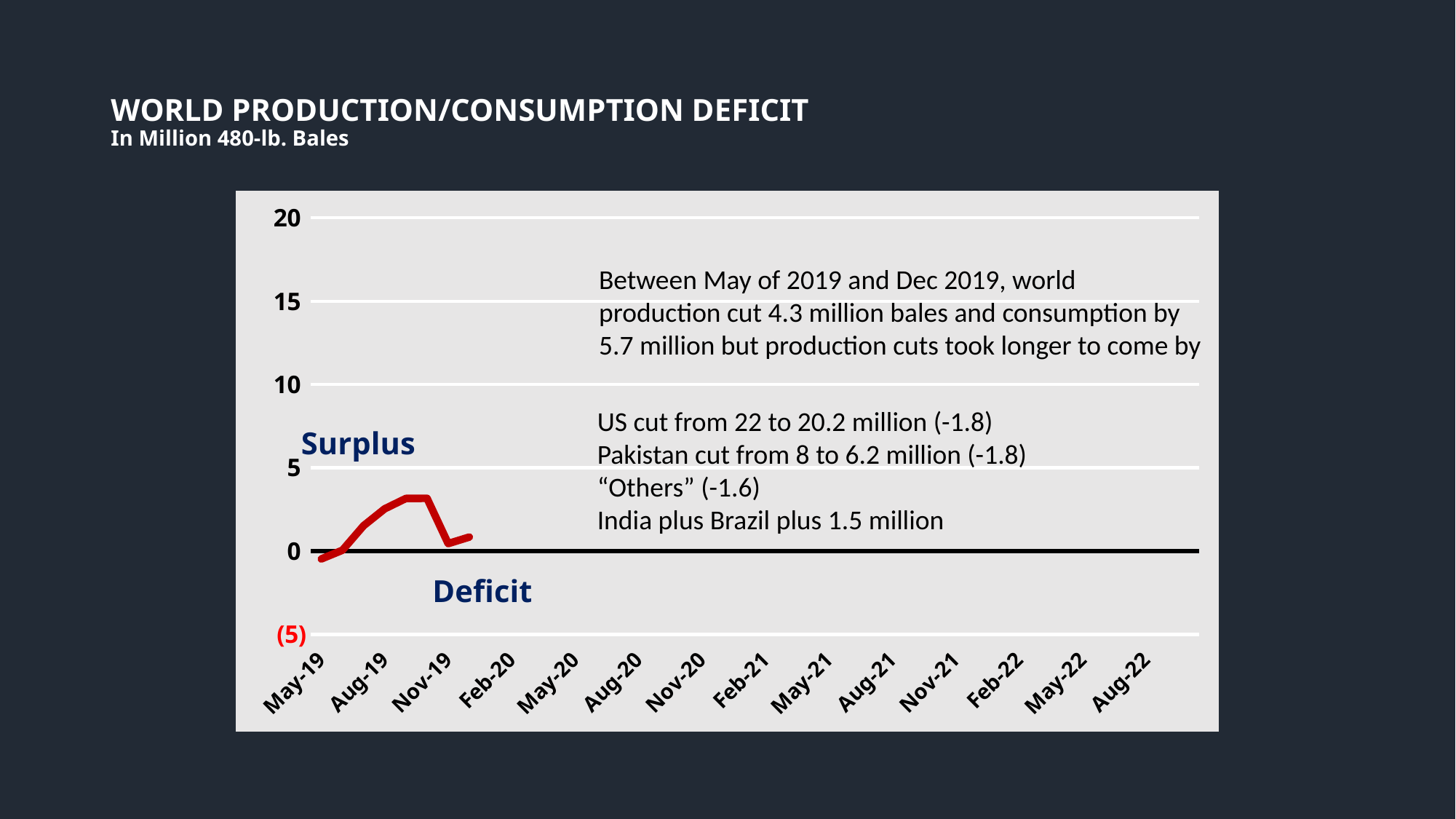
How many date labels are shown along the x axis? 14 Is the value for Nov-19 greater or less than 5? less Is the value for Aug-19 greater or less than 0? greater At which x-axis label does the red line reach its lowest point? May-19 In what units are the values on the chart expressed, according to the subtitle? Million 480-lb. Bales Is the value for Aug-19 greater or less than 5? less What kind of chart is shown on the slide? line chart Which is larger, the value at Nov-19 or the value at May-19? Nov-19 What is the title of the chart? WORLD PRODUCTION/CONSUMPTION DEFICIT